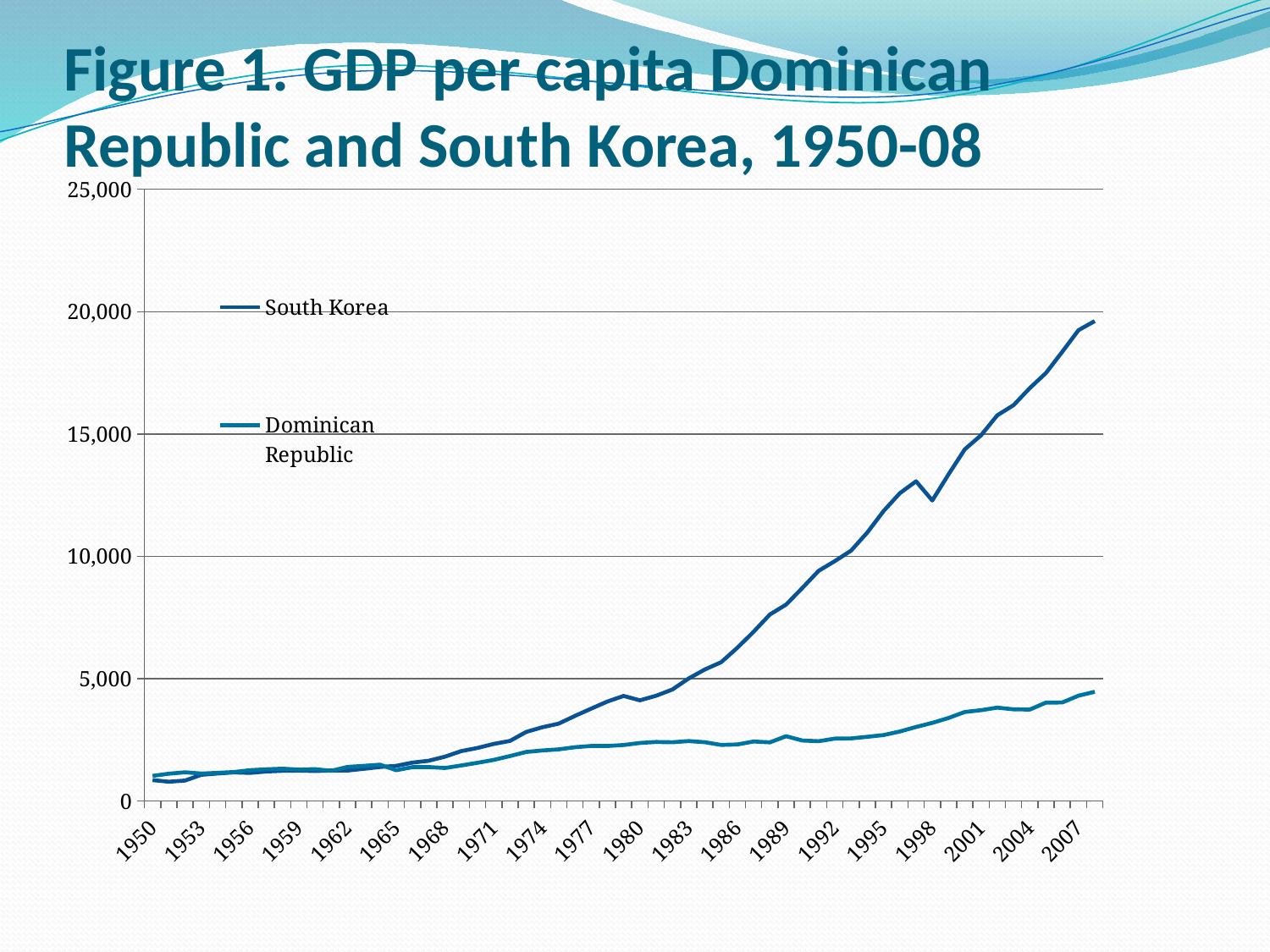
Is the value for South Korea in 1980 greater or less than 5,000? less Which series reaches the highest value on the chart? South Korea Is the value for South Korea in 1989 greater or less than 5,000? greater How many series does the legend list? 2 Is the value for the Dominican Republic in 2007 greater or less than 5,000? less Does the South Korea line generally rise or fall from 1950 to 2008? rise What are the two series named in the legend? South Korea and Dominican Republic What is the title of the chart? Figure 1. GDP per capita Dominican Republic and South Korea, 1950-08 What kind of chart is shown on the slide? line chart In 2007, which series has the larger value, South Korea or the Dominican Republic? South Korea